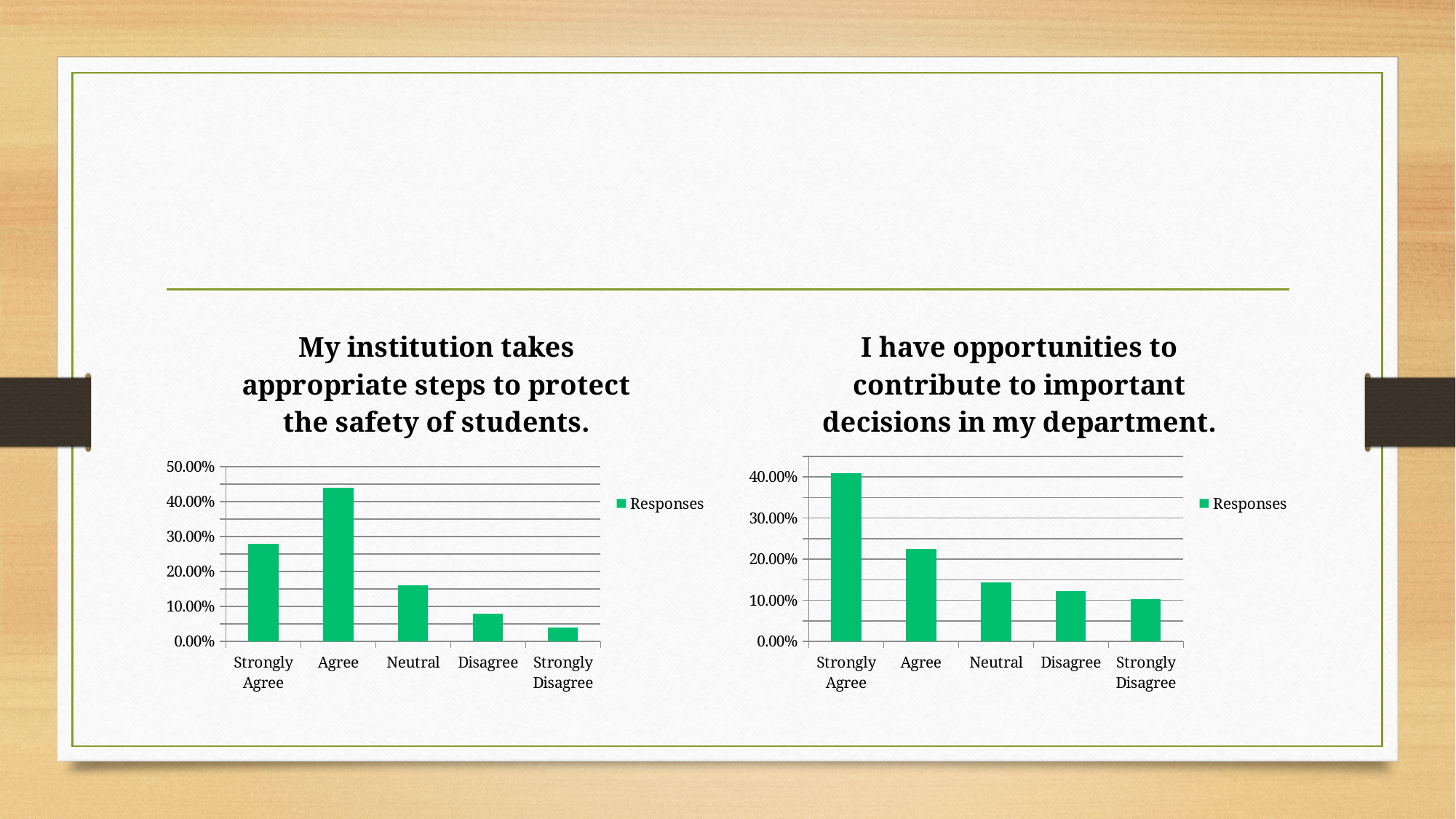
In the right chart, is the value for Agree greater or less than 30.00%? less How many categories are shown on the x axis of the left chart? 5 In the chart titled "I have opportunities to contribute to important decisions in my department.", which category has the highest value? Strongly Agree In the left chart, is the value for Agree greater or less than 40.00%? greater What kind of chart is the chart on the right? bar chart In the left chart, is the value for Strongly Agree greater or less than 30.00%? less In the chart titled "I have opportunities to contribute to important decisions in my department.", which category has the lowest value? Strongly Disagree In the right chart, do the values rise or fall from Strongly Agree to Strongly Disagree? fall In the chart titled "My institution takes appropriate steps to protect the safety of students.", which category has the highest value? Agree In the left chart, which is larger, the value for Neutral or the value for Disagree? Neutral In the chart titled "My institution takes appropriate steps to protect the safety of students.", which category has the lowest value? Strongly Disagree